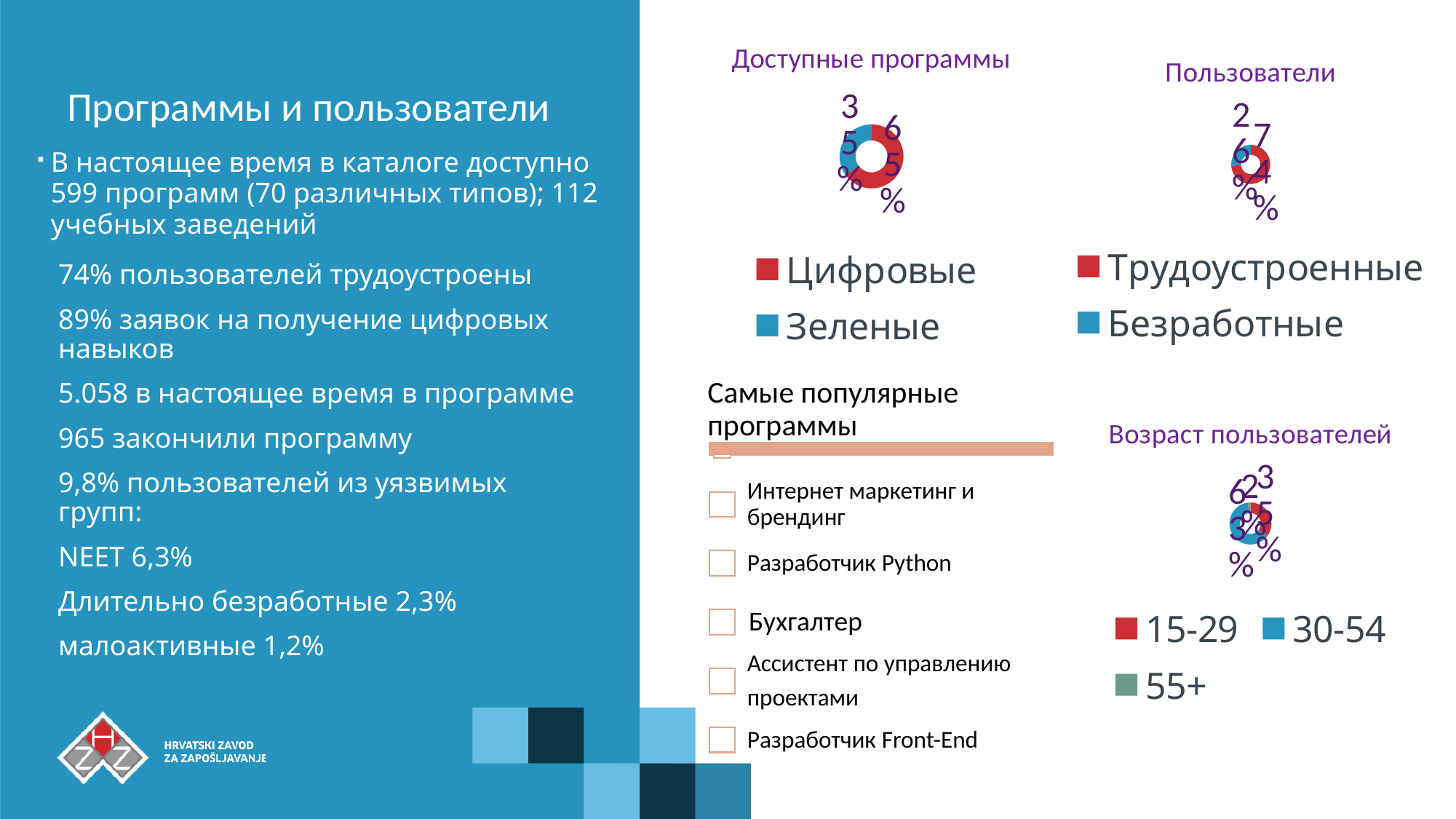
What kind of chart is the one titled "Возраст пользователей"? Pie (donut) chart In the chart titled "Доступные программы", what is the value for Цифровые? 65% In the chart titled "Пользователи", what is the value for Трудоустроенные? 74% In the chart titled "Доступные программы", which category has the larger share? Цифровые In the chart titled "Пользователи", what is the difference between Трудоустроенные and Безработные? 48 percentage points In the chart titled "Пользователи", what is the value for Безработные? 26% How many categories does the legend of the chart titled "Доступные программы" list? 2 How many categories does the legend of the chart titled "Возраст пользователей" list? 3 In the chart titled "Возраст пользователей", which colour represents the 55+ category? Green In the chart titled "Пользователи", which category is smaller? Безработные In the chart titled "Доступные программы", what is the difference between Цифровые and Зеленые? 30 percentage points In the chart titled "Доступные программы", what is the value for Зеленые? 35%